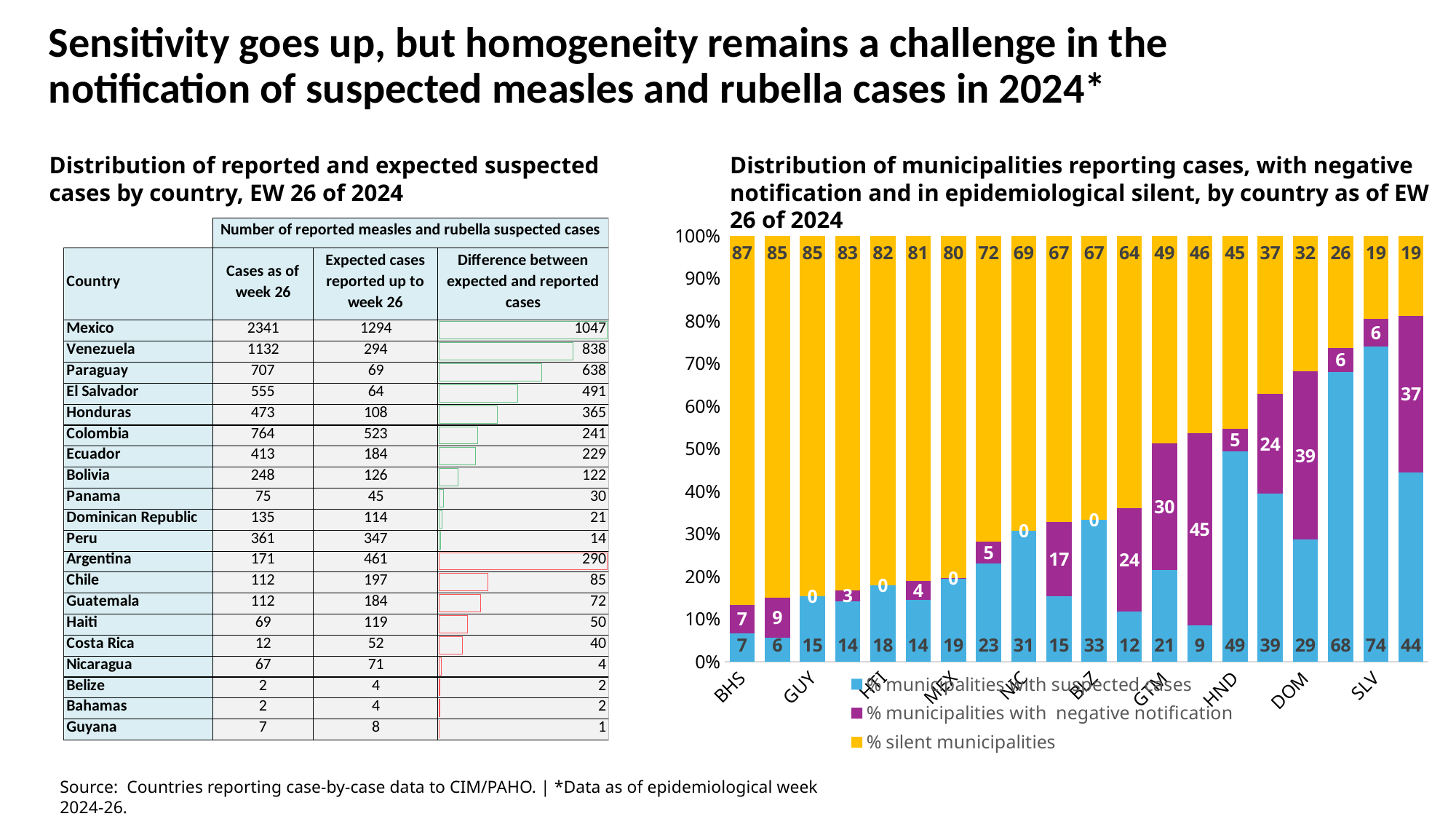
In the stacked bar chart, what is the percentage of silent municipalities for BHS? 87 In the stacked bar chart, what is the percentage of municipalities with negative notification for MEX? 0 Which country has the highest percentage of municipalities with suspected cases in the stacked bar chart? SLV In the stacked bar chart, what is the percentage of municipalities with suspected cases for SLV? 74 How many series does the legend of the stacked bar chart list? 3 In the stacked bar chart, what is the percentage of municipalities with negative notification for DOM? 39 In the stacked bar chart, which has a larger percentage of municipalities with negative notification, GTM or HND? GTM In the stacked bar chart, what is the difference between the percentage of silent municipalities for DOM and for SLV? 13 Which country has the highest percentage of silent municipalities in the stacked bar chart? BHS In the stacked bar chart, which colour represents the % silent municipalities series? Yellow How many country bars are plotted in the stacked bar chart? 20 What kind of chart is shown on the right side of the slide? Stacked bar chart